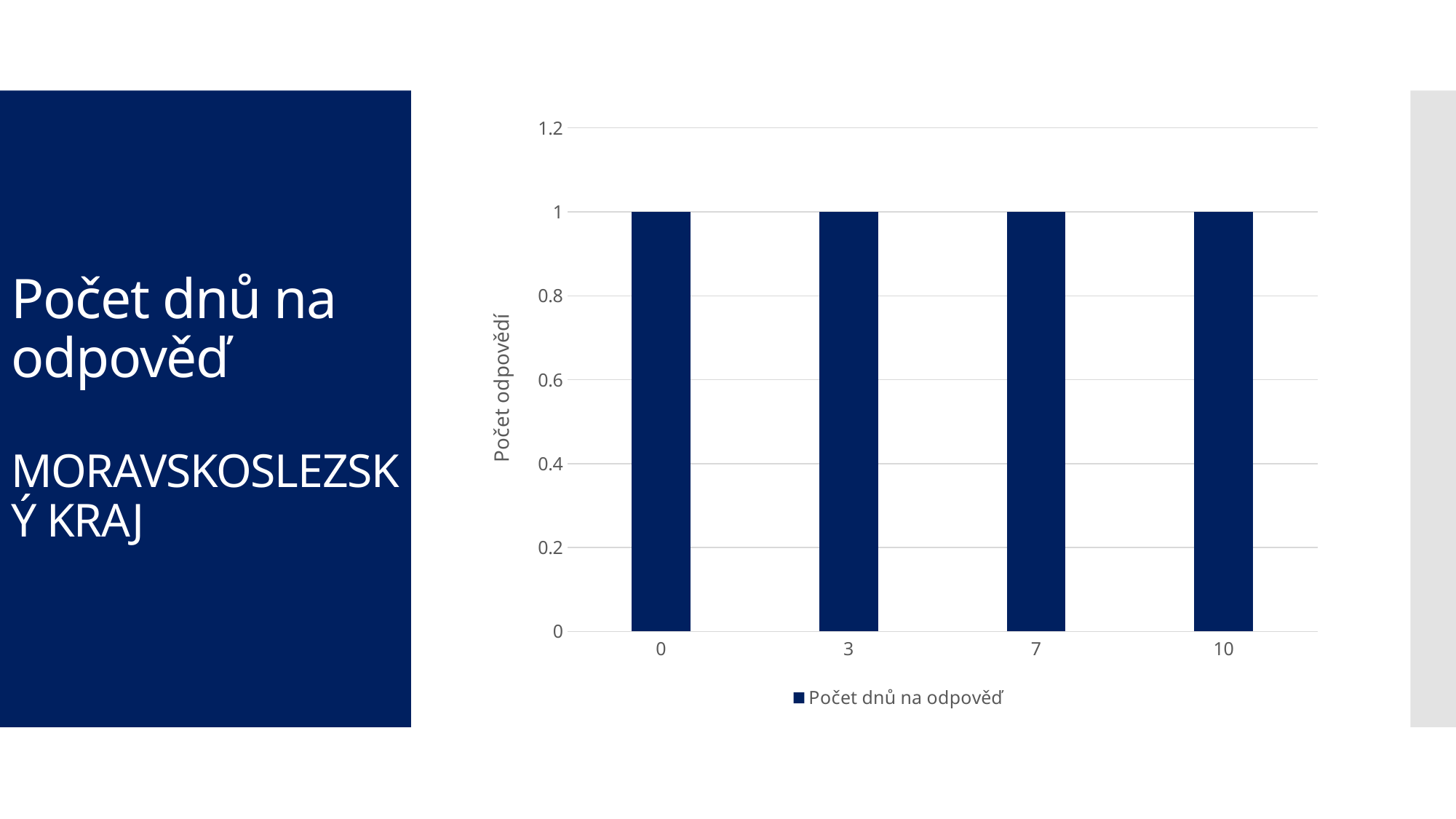
What is the label of the vertical axis? Počet odpovědí What is the value of the bar for category 7? 1 What is the difference between the values for category 0 and category 10? 0 How many bars (categories) does the chart show? 4 How many series does the legend list? 1 What is the value of the bar for category 10? 1 Do the values rise, fall, or stay the same across the categories on the x axis? stay the same What is the value of the bar for category 3? 1 Is the value for category 7 greater or less than 0.8? greater What is the name of the series shown in the legend? Počet dnů na odpověď What kind of chart is shown on the slide? bar chart What is the value of the bar for category 0? 1